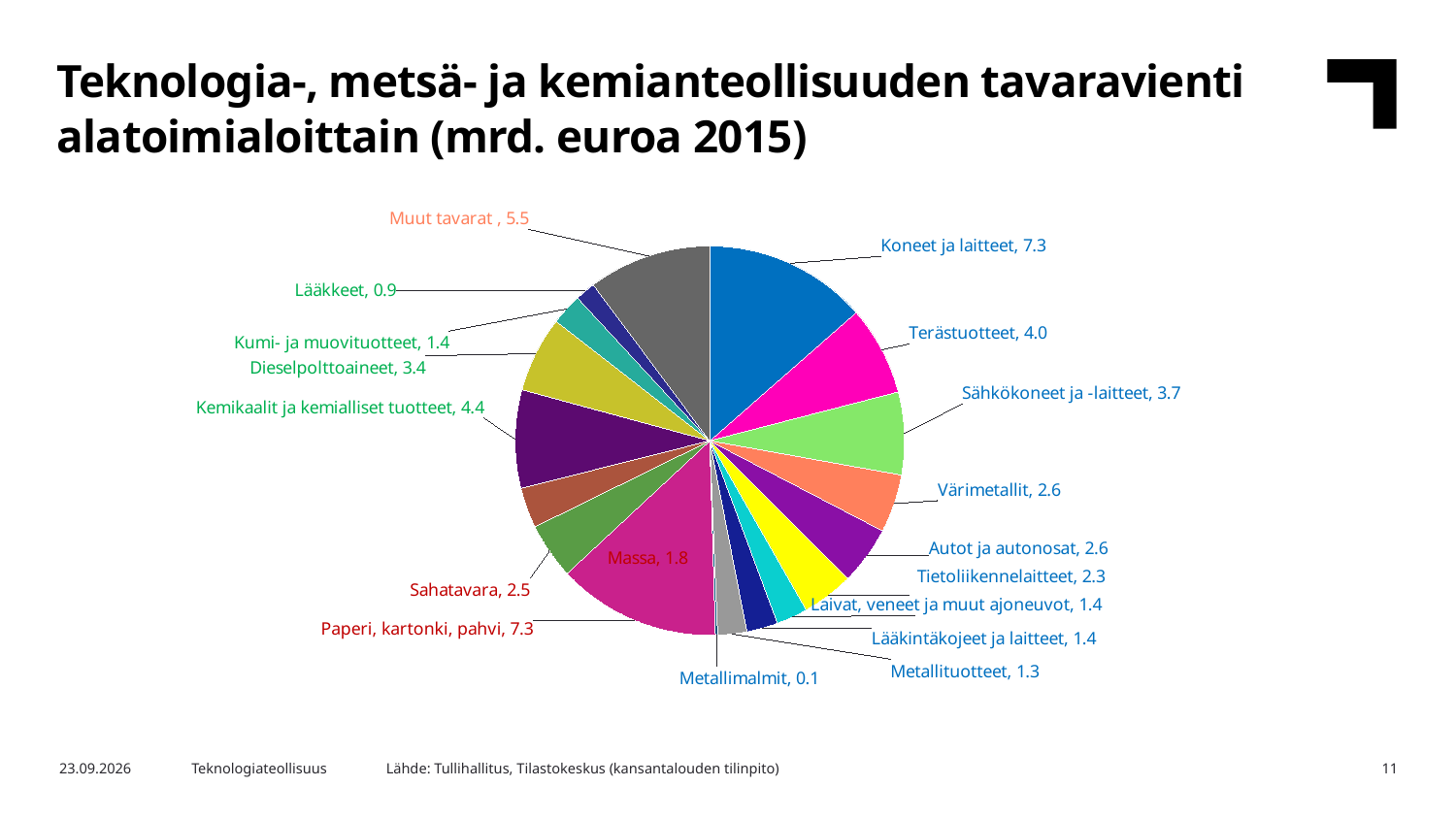
What is the title of the chart on the slide? Teknologia-, metsä- ja kemianteollisuuden tavaravienti alatoimialoittain (mrd. euroa 2015) What kind of chart is shown on the slide? pie chart What is the difference between Muut tavarat and Kemikaalit ja kemialliset tuotteet? 1.1 What is the difference between Koneet ja laitteet and Terästuotteet? 3.3 What is the value for Koneet ja laitteet? 7.3 Which category has the lowest value? Metallimalmit What is the value for Kemikaalit ja kemialliset tuotteet? 4.4 What is the value for Massa? 1.8 Which is larger, Sähkökoneet ja -laitteet or Dieselpolttoaineet? Sähkökoneet ja -laitteet How many categories does the pie chart show? 18 What is the value for Terästuotteet? 4.0 What is the value for Muut tavarat? 5.5